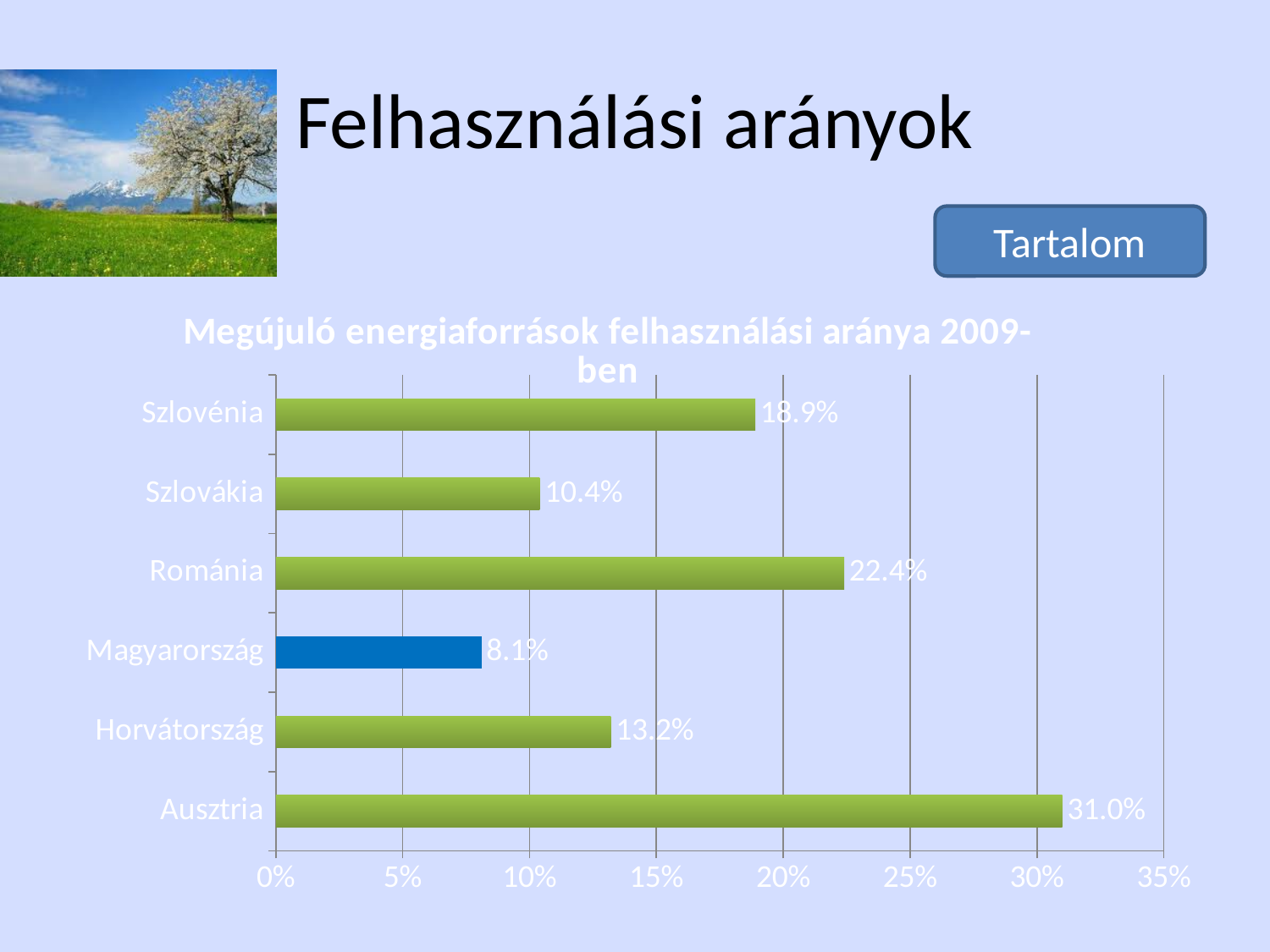
What is the value for Szlovénia? 18.9% What is the value for Románia? 22.4% What is the difference between the values for Szlovénia and Horvátország? 5.7% Which country's bar is shown in a different colour (blue) from the others? Magyarország Which is larger, the value for Szlovákia or the value for Horvátország? Horvátország Which country has the highest value? Ausztria What kind of chart is shown on the slide? Bar chart What is the value for Magyarország? 8.1% What is the difference between the values for Ausztria and Magyarország? 22.9% What is the value for Ausztria? 31.0% Which country has the lowest value? Magyarország How many countries are shown in the chart? 6